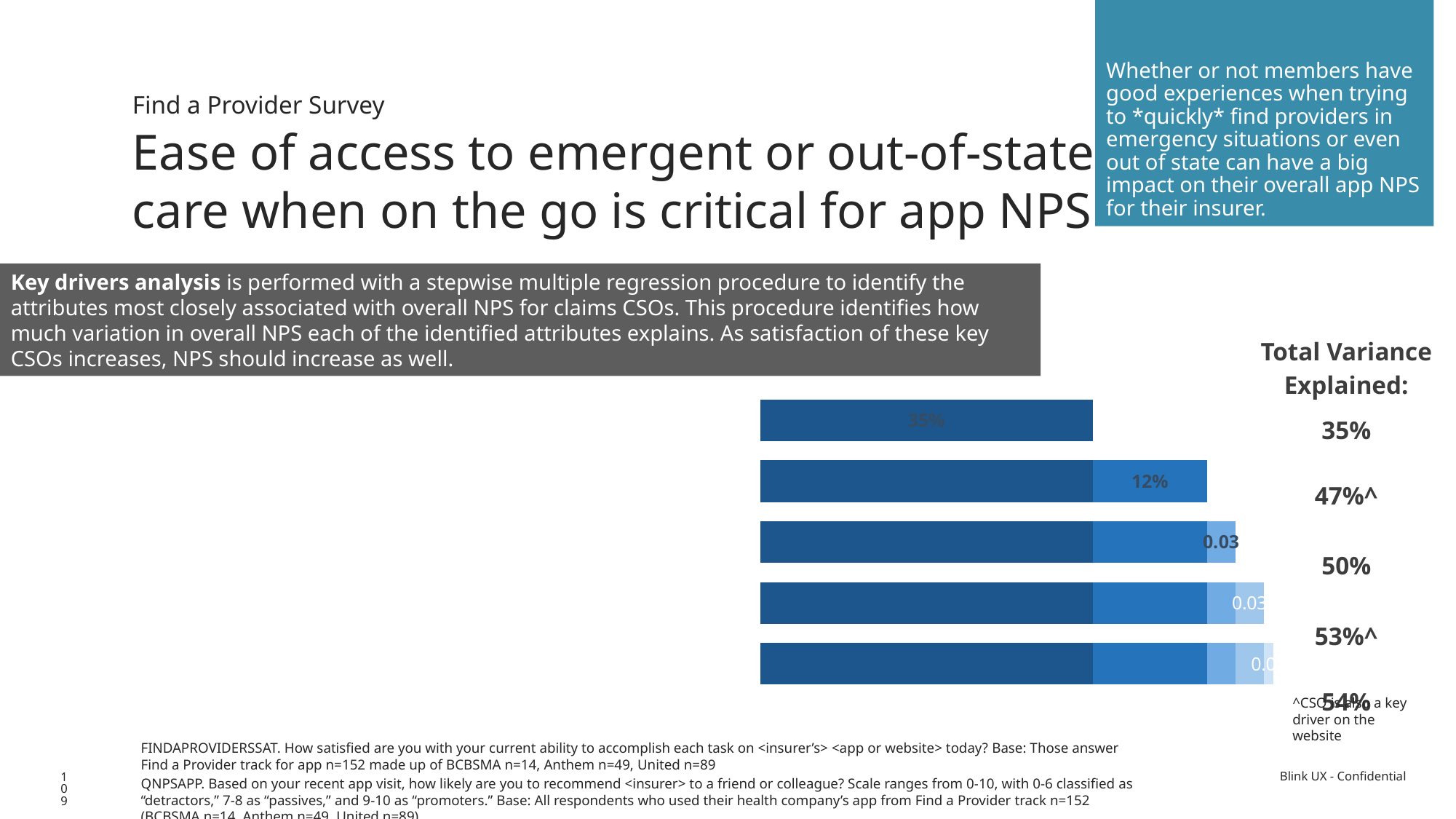
How many bars are plotted in the chart? 5 What value is labelled on the fourth segment of the fourth bar from the top? 0.03 What value is labelled on the second segment of the second bar from the top? 12% What value is labelled on the third segment of the third bar from the top? 0.03 Which bar is the longest in the chart, the top bar or the bottom bar? bottom bar Do the bar lengths increase or decrease going from the top bar to the bottom bar? increase Which bar is the shortest in the chart? the top bar What is the Total Variance Explained value listed for the first (top) bar? 35% What kind of chart is shown on the slide? bar chart What is the heading of the column of values to the right of the chart? Total Variance Explained: What is the Total Variance Explained value listed for the second bar from the top? 47%^ What value is labelled on the first (top) bar of the chart? 35%